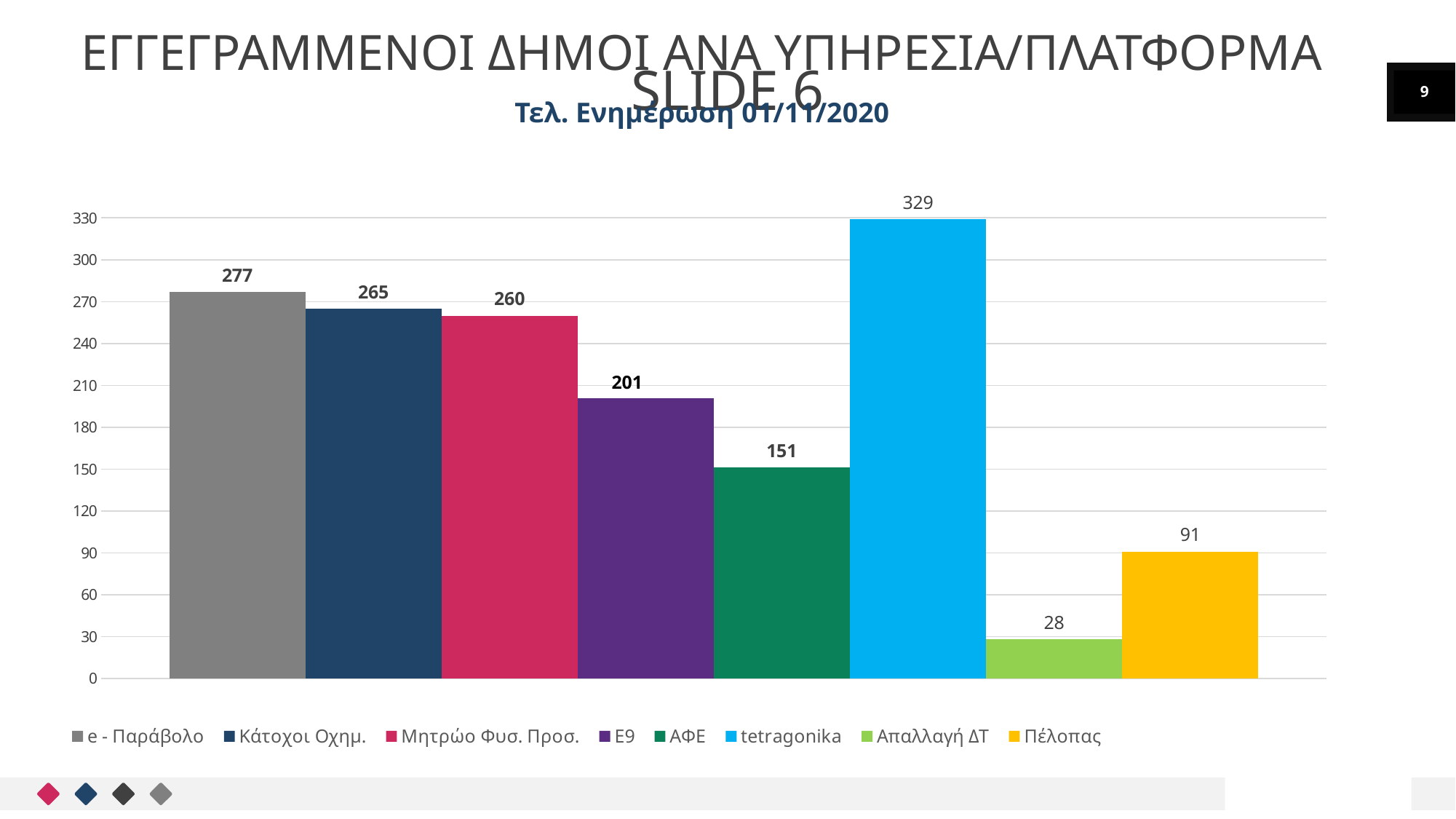
What is the value for tetragonika? 329 What is the value for e - Παράβολο? 277 What is the difference between the values for Πέλοπας and Απαλλαγή ΔΤ? 63 What colour is the bar for tetragonika? Light blue What is the value for Απαλλαγή ΔΤ? 28 What is the value for ΑΦΕ? 151 Which series has the lowest value? Απαλλαγή ΔΤ What kind of chart is shown on the slide? Bar chart How many series does the legend list? 8 What is the difference between the values for tetragonika and e - Παράβολο? 52 Which is larger, the value for E9 or the value for ΑΦΕ? E9 Which series has the highest value? tetragonika